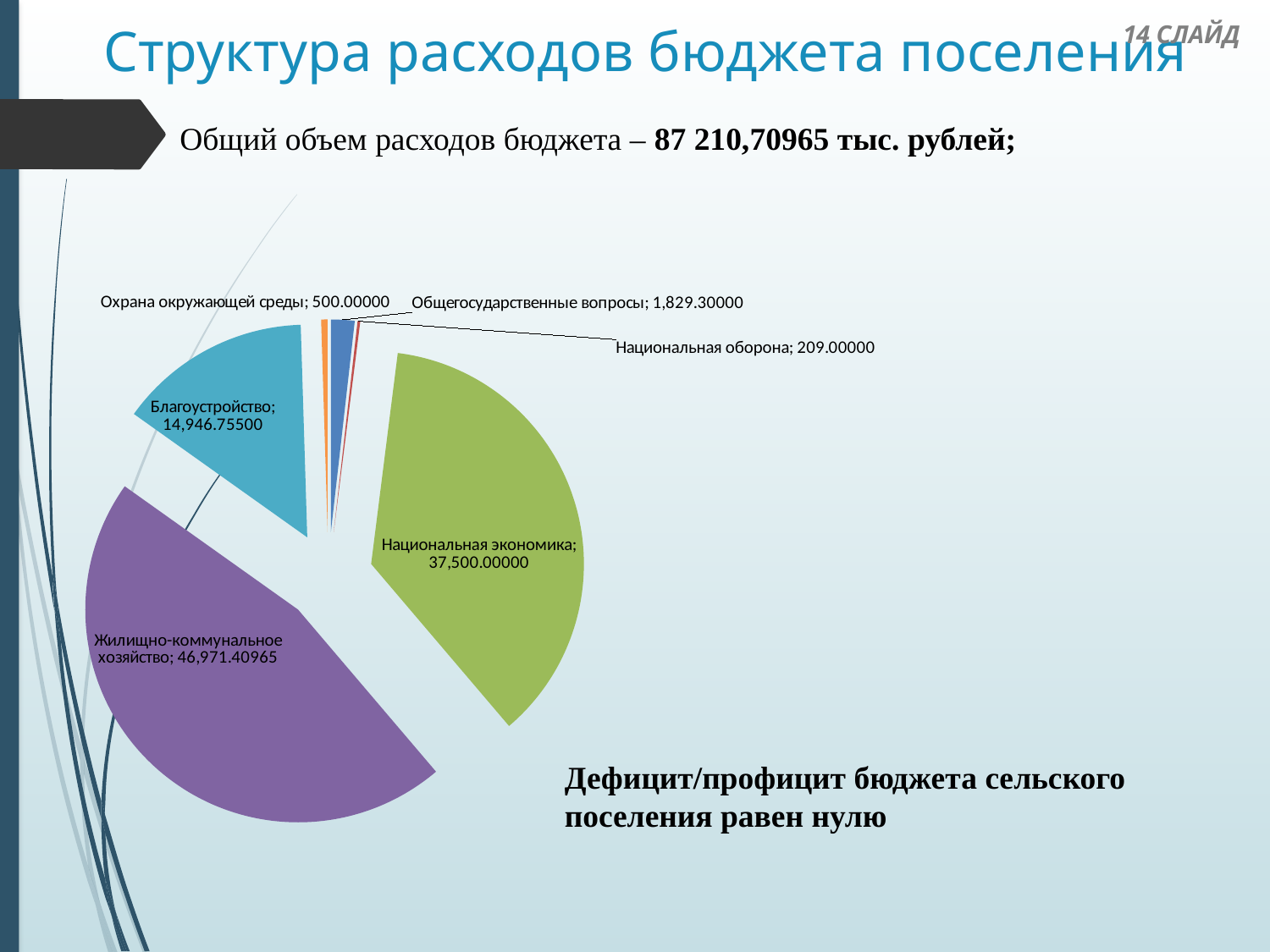
What is the difference between the values for Жилищно-коммунальное хозяйство and Национальная экономика? 9,471.40965 What is the value for Национальная экономика? 37,500.00000 What is the value for Национальная оборона? 209.00000 What kind of chart is shown on the slide? pie chart How many slices does the pie chart have? 6 What is the value for Охрана окружающей среды? 500.00000 Which is larger, the value for Общегосударственные вопросы or the value for Охрана окружающей среды? Общегосударственные вопросы Which category has the smallest slice of the pie? Национальная оборона What is the value for Благоустройство? 14,946.75500 What is the value for Жилищно-коммунальное хозяйство? 46,971.40965 Which category has the largest slice of the pie? Жилищно-коммунальное хозяйство What is the title of the slide containing the pie chart? Структура расходов бюджета поселения